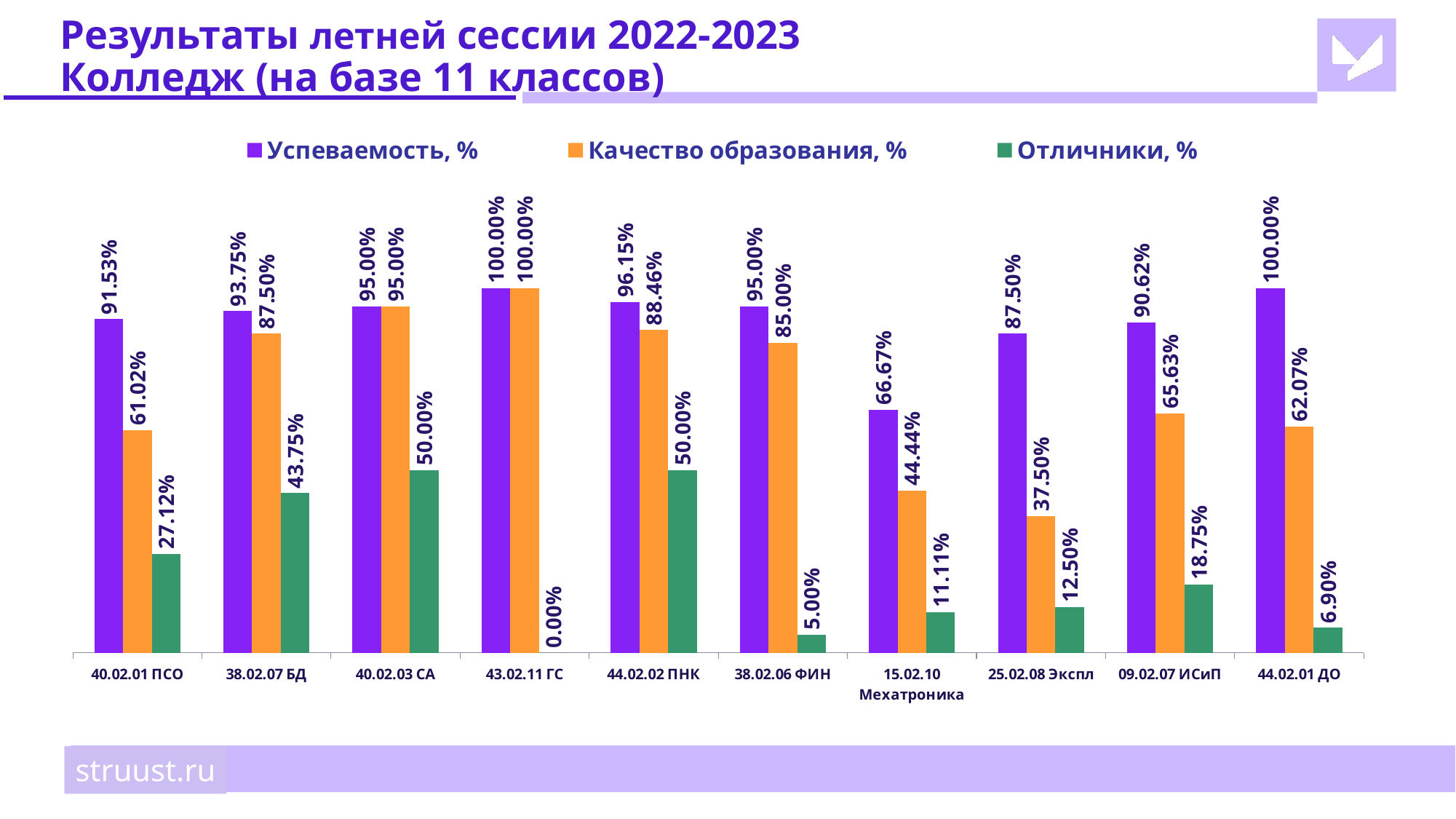
Which category has the lowest value of Успеваемость, %? 15.02.10 Мехатроника What is the value of Качество образования, % for 15.02.10 Мехатроника? 44.44% What kind of chart is shown on the slide? Bar chart What is the difference between Успеваемость, % and Качество образования, % for 25.02.08 Экспл? 50.00% Which category has the highest value of Качество образования, %? 43.02.11 ГС How many categories are shown on the x axis? 10 What is the value of Отличники, % for 38.02.07 БД? 43.75% Which category has the lowest value of Отличники, %? 43.02.11 ГС What is the value of Качество образования, % for 09.02.07 ИСиП? 65.63% What is the value of Успеваемость, % for 40.02.01 ПСО? 91.53% Which is larger: Отличники, % for 40.02.01 ПСО or for 09.02.07 ИСиП? 40.02.01 ПСО How many series does the legend list? 3